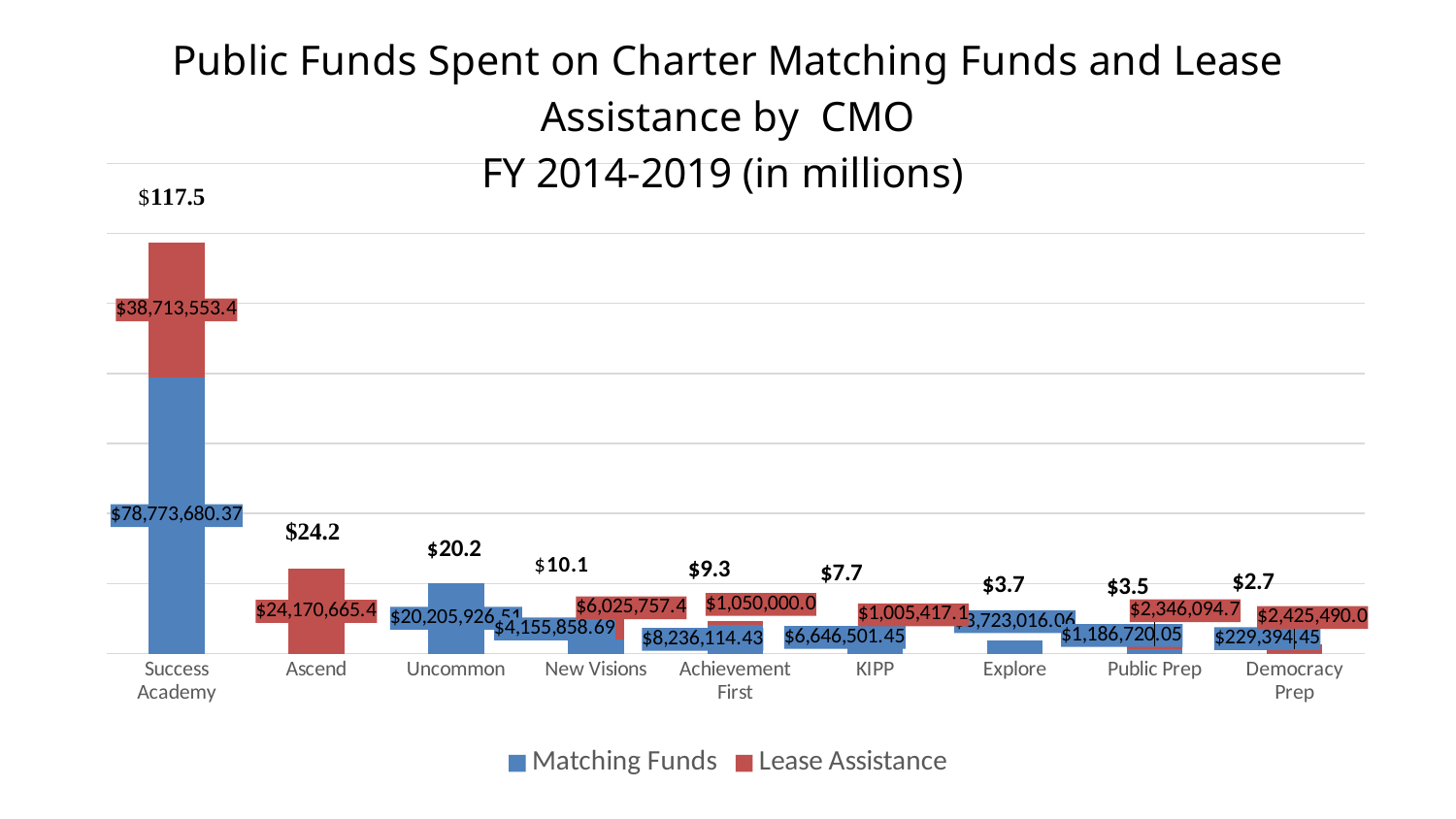
How many series does the legend list? 2 What is the total (in millions) shown above the bar for Ascend? $24.2 Which has a larger total, Uncommon or New Visions? Uncommon Which CMO has the lowest total of public funds? Democracy Prep What is the Lease Assistance value for Success Academy? $38,713,553.4 Do the bar totals rise or fall from left to right along the x axis? fall How many CMOs are shown on the x axis? 9 Which CMO has the highest total of public funds? Success Academy What kind of chart is shown on the slide? bar chart What is the Matching Funds value for Success Academy? $78,773,680.37 What is the Lease Assistance value for New Visions? $6,025,757.4 What is the difference between the totals shown for Ascend and Uncommon? $4.0